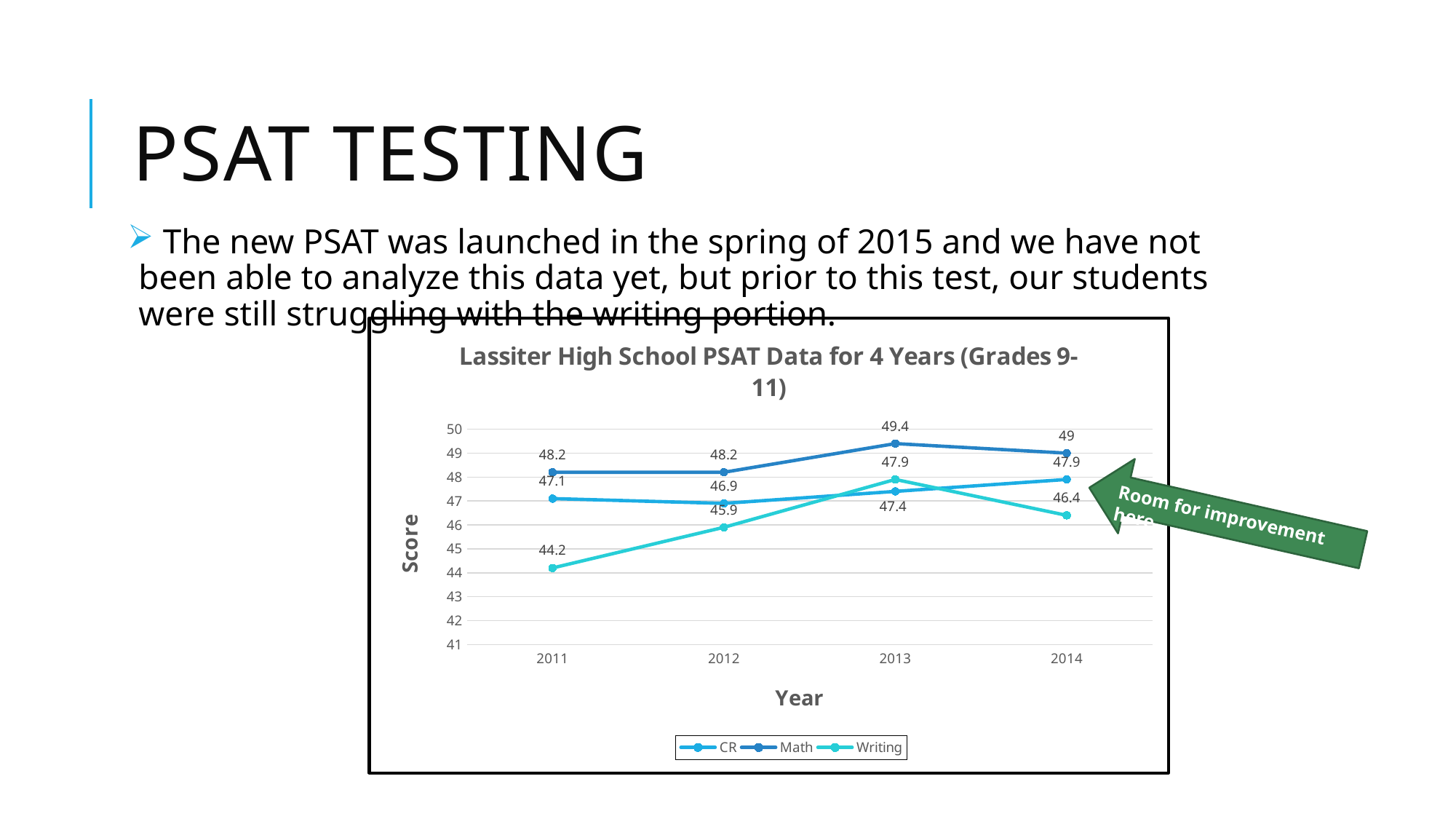
What is the difference between the Math and Writing scores in 2011? 4 In which year was the CR score lowest? 2012 What is the title of the chart? Lassiter High School PSAT Data for 4 Years (Grades 9-11) Did the Writing score rise or fall from 2013 to 2014? fall What was the Math score in 2013? 49.4 How many years are plotted on the x axis? 4 In which year was the Writing score highest? 2013 What type of chart is shown on the slide? line chart How many series does the legend list? 3 What was the CR score in 2014? 47.9 Which series had the higher score in 2014, CR or Writing? CR What was the Writing score in 2011? 44.2